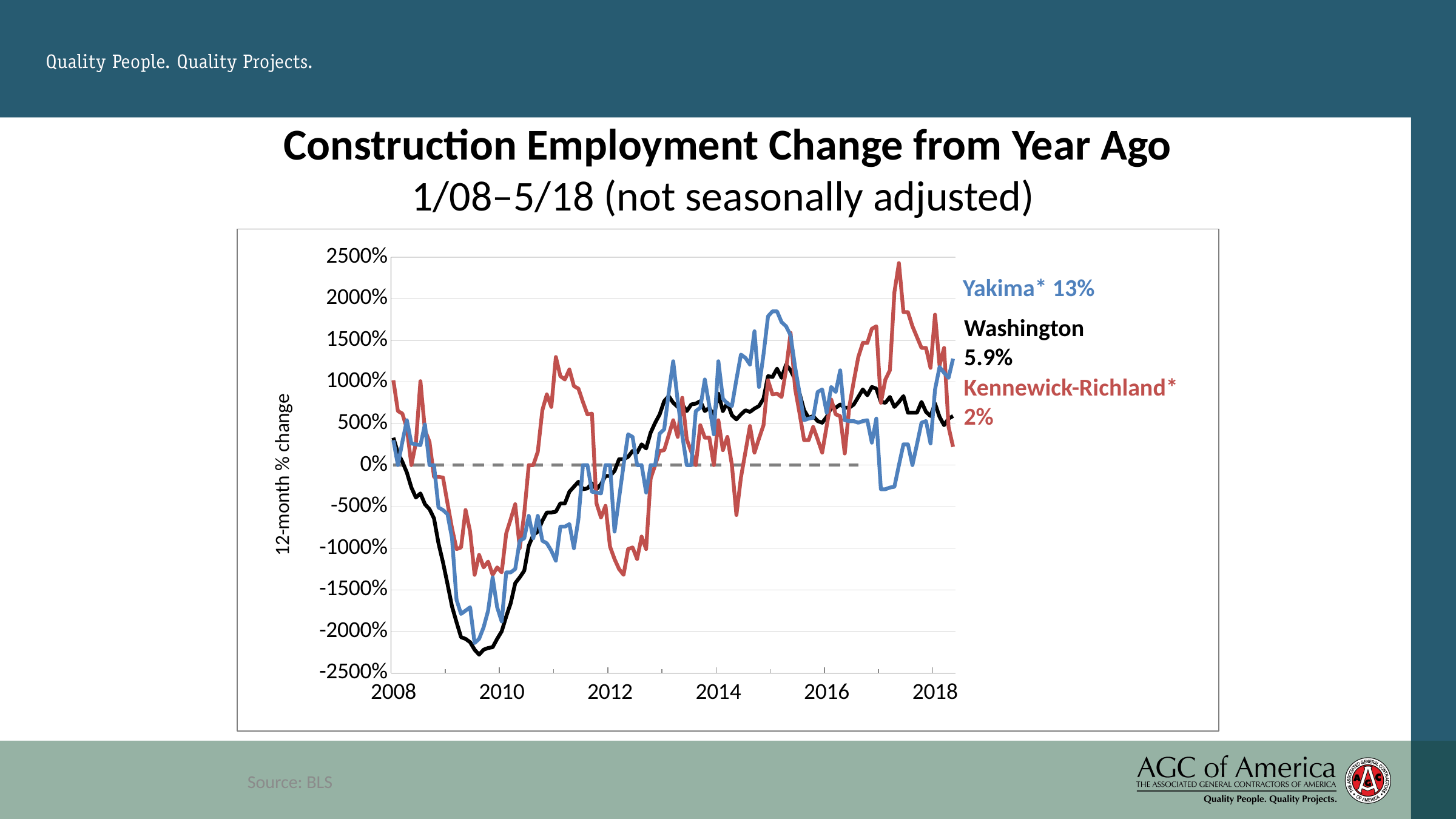
What is the latest value shown for Washington? 5.9% What is the latest value shown for Yakima? 13% What kind of chart is shown on the slide? Line chart What is the latest value shown for Kennewick-Richland? 2% Which series has the lowest latest value labeled on the chart? Kennewick-Richland Which series has the highest latest value labeled on the chart? Yakima What is the difference between the latest values for Yakima and Kennewick-Richland? 11% What is the difference between the latest values for Washington and Kennewick-Richland? 3.9% Is the peak of the Kennewick-Richland line in 2017 greater or less than 2000%? greater Is the lowest point of the Washington line in 2009 greater or less than -2000%? less How many series are plotted on the chart? 4 Which has the larger latest value, Washington or Kennewick-Richland? Washington